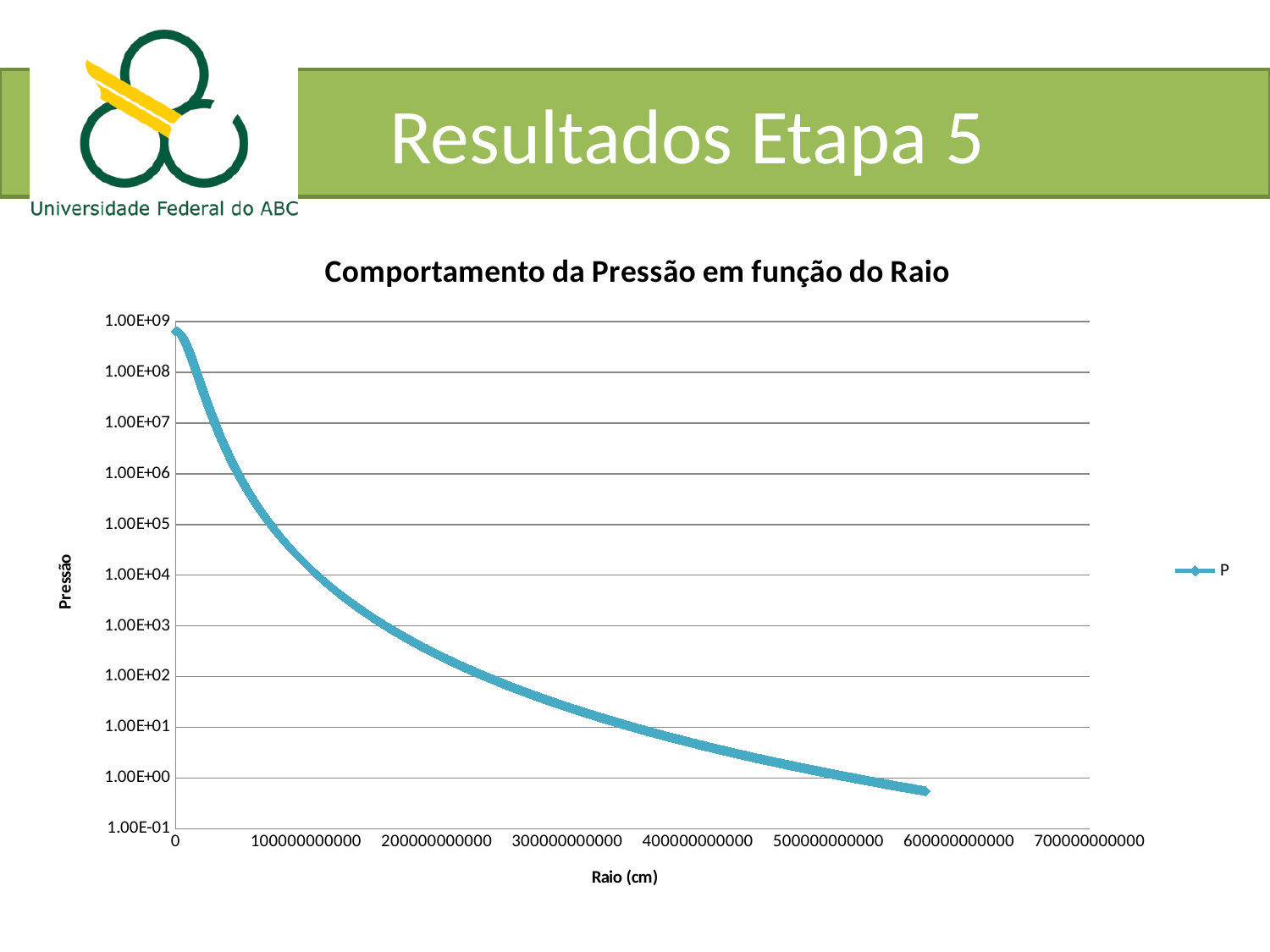
Is the value of P at Raio = 200000000000 greater or less than 1.00E+02? greater Is the value of P at Raio = 200000000000 greater or less than 1.00E+03? less Which is larger, the value of P at Raio = 100000000000 or at Raio = 400000000000? Raio = 100000000000 How many series does the legend list? 1 Does the pressure (Pressão) rise or fall as the radius (Raio) increases along the x axis? fall Is the value of P at Raio = 400000000000 greater or less than 1.00E+01? less What is the title of the chart? Comportamento da Pressão em função do Raio At which end of the x axis does the series P reach its highest value, near Raio = 0 or near Raio = 600000000000? near Raio = 0 What is the name of the series shown in the legend? P What kind of chart is shown on the slide? line chart